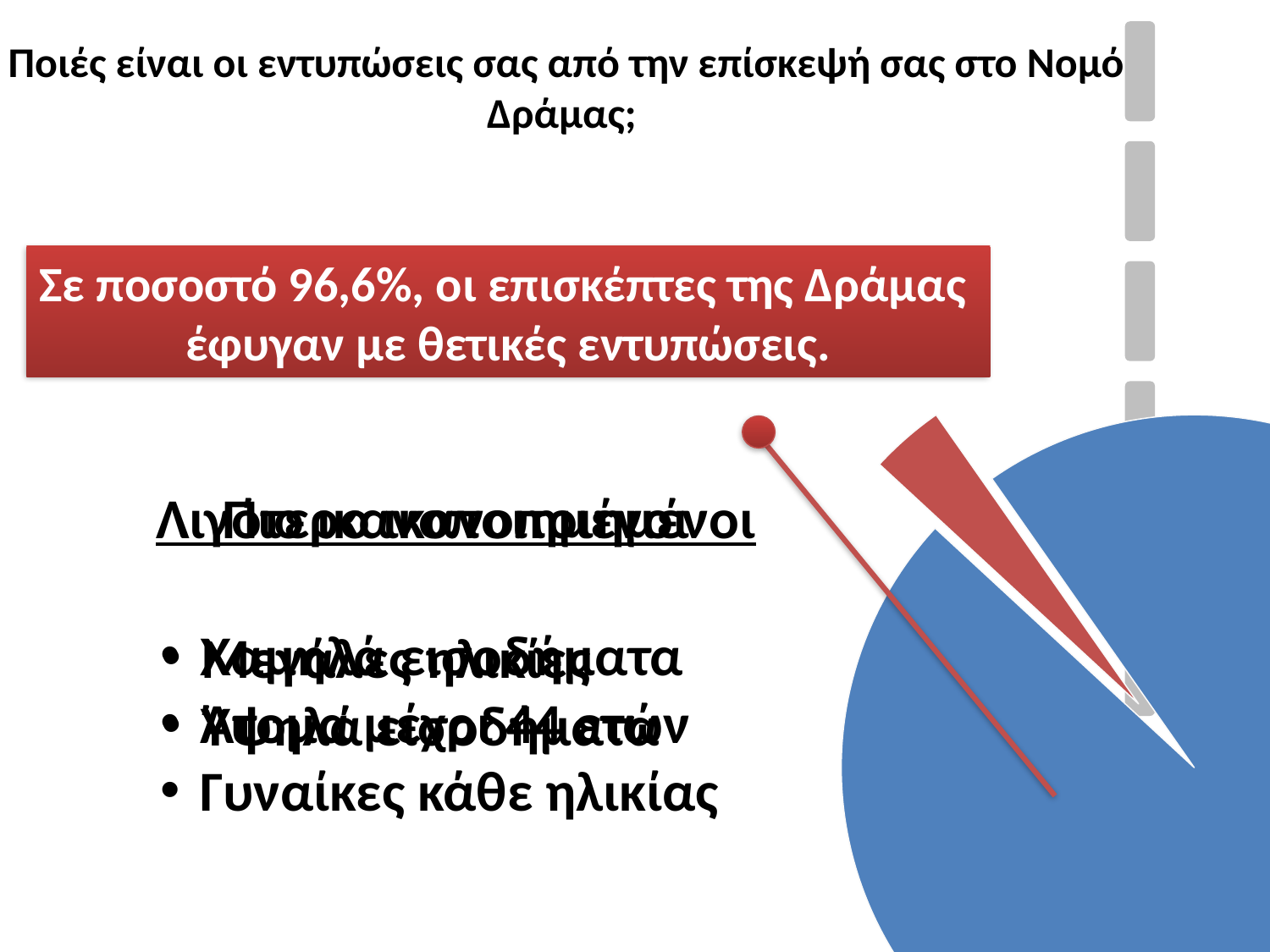
Which slice is larger in the pie chart, the blue one or the red one? blue Which colour slice is the largest in the pie chart? blue Which slice of the pie chart is pulled out (exploded) from the rest? the red slice What kind of chart is shown on the slide? pie chart Does the pie chart display a legend? No How many slices does the pie chart have? 2 Which colour slice is the smallest in the pie chart? red